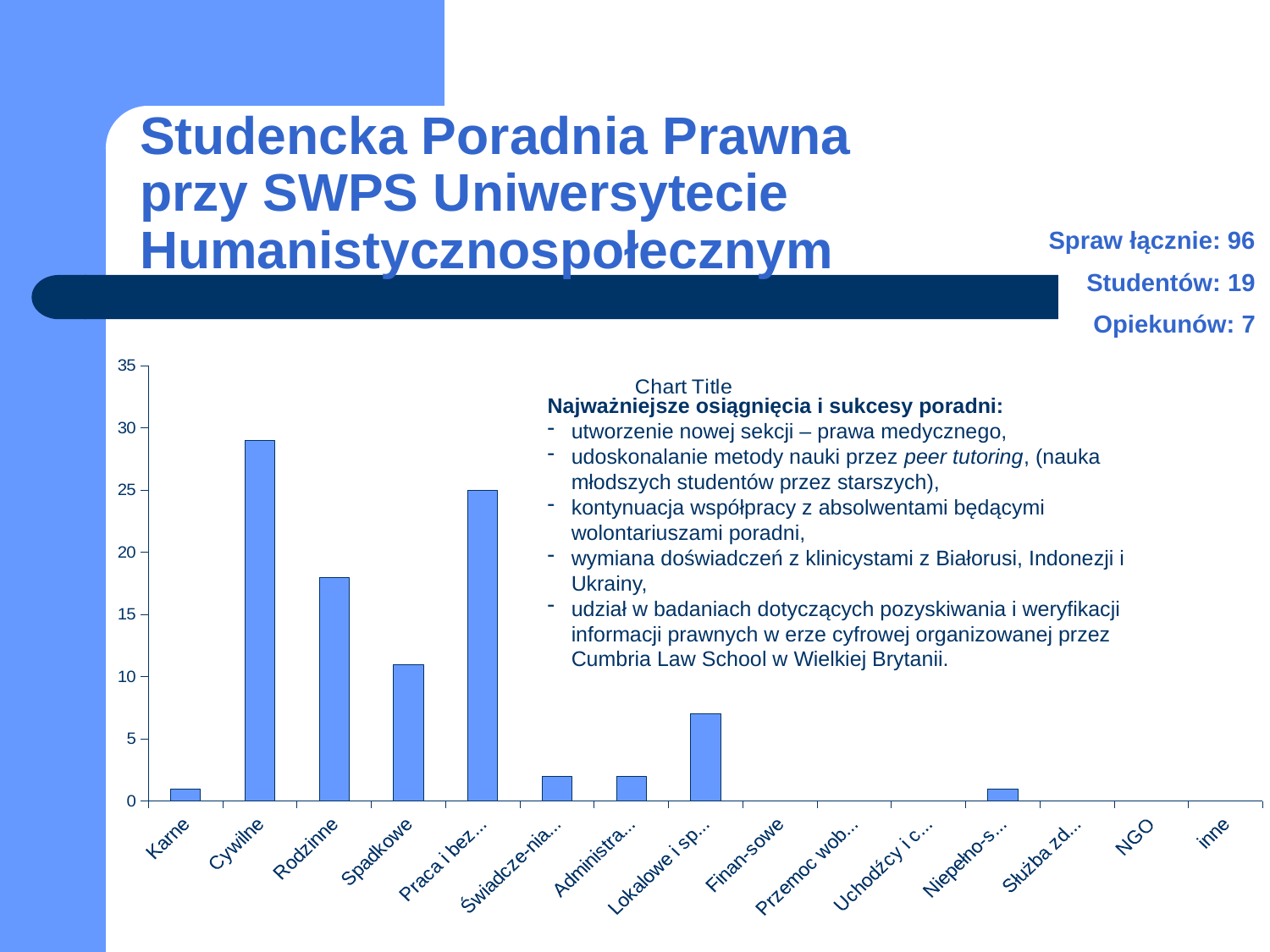
Is the value for Lokalowe i sp... greater or less than 10? less What is the title shown on the chart? Chart Title Is the value for Praca i bez... greater or less than 20? greater Which is larger, the value for Rodzinne or the value for Spadkowe? Rodzinne How many categories are shown on the x axis of the chart? 15 What kind of chart is shown on the slide? bar chart Is the value for Cywilne greater or less than 25? greater Which is larger, the value for Cywilne or the value for Praca i bez...? Cywilne Which category has the highest bar in the chart? Cywilne